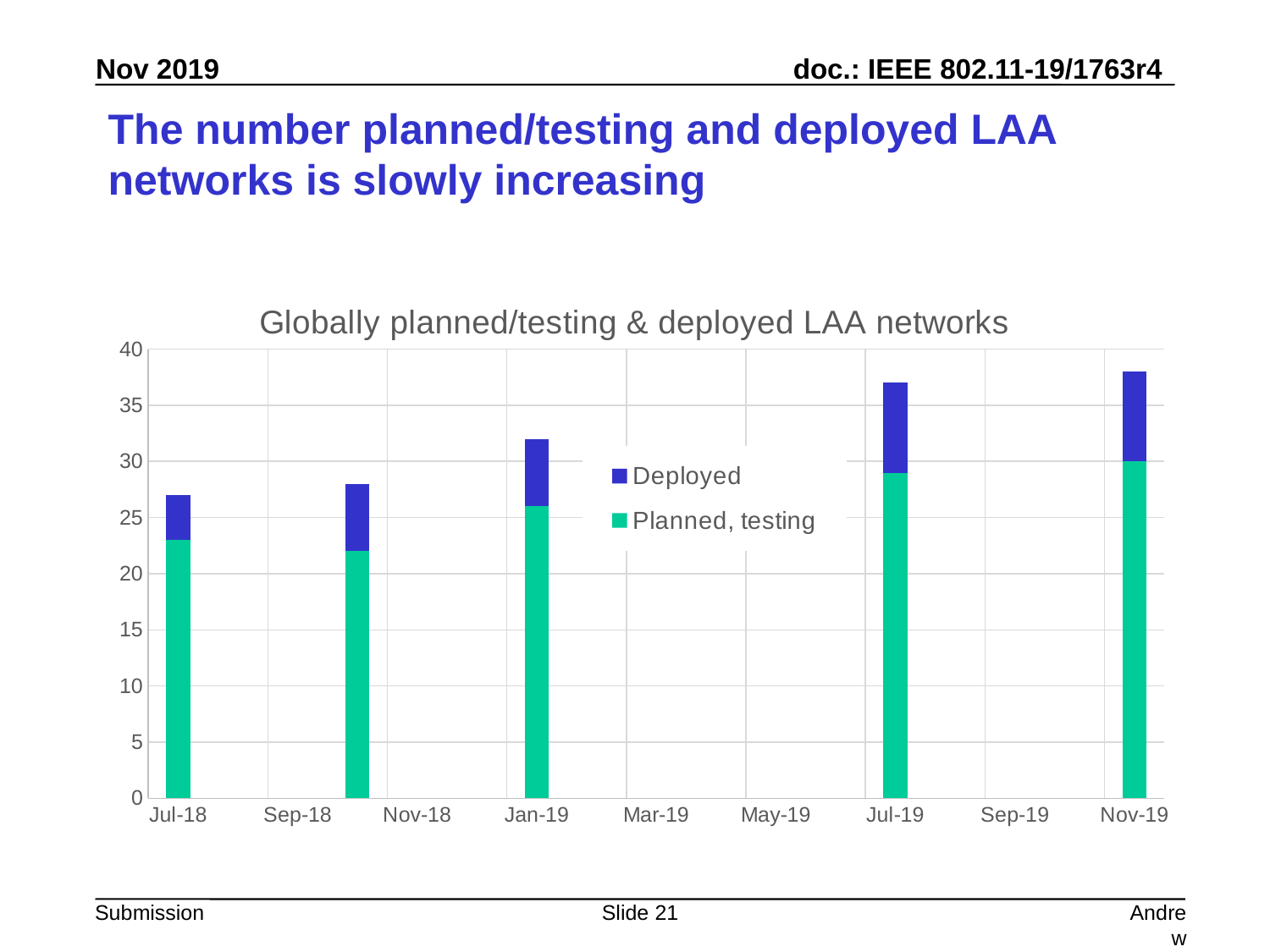
Which series is shown in green? Planned, testing Do the total bar heights rise or fall from Jul-18 to Nov-19? Rise Which date has the tallest stacked bar? Nov-19 Is the total stacked value for Jul-18 greater or less than 30? less How many bars are plotted in the chart? 5 How many series does the legend list? 2 Is the total stacked value for Jul-19 greater or less than 35? greater Is the total stacked value for Jan-19 greater or less than 30? greater What is the title of the chart? Globally planned/testing & deployed LAA networks What type of chart is shown on the slide? Stacked bar chart